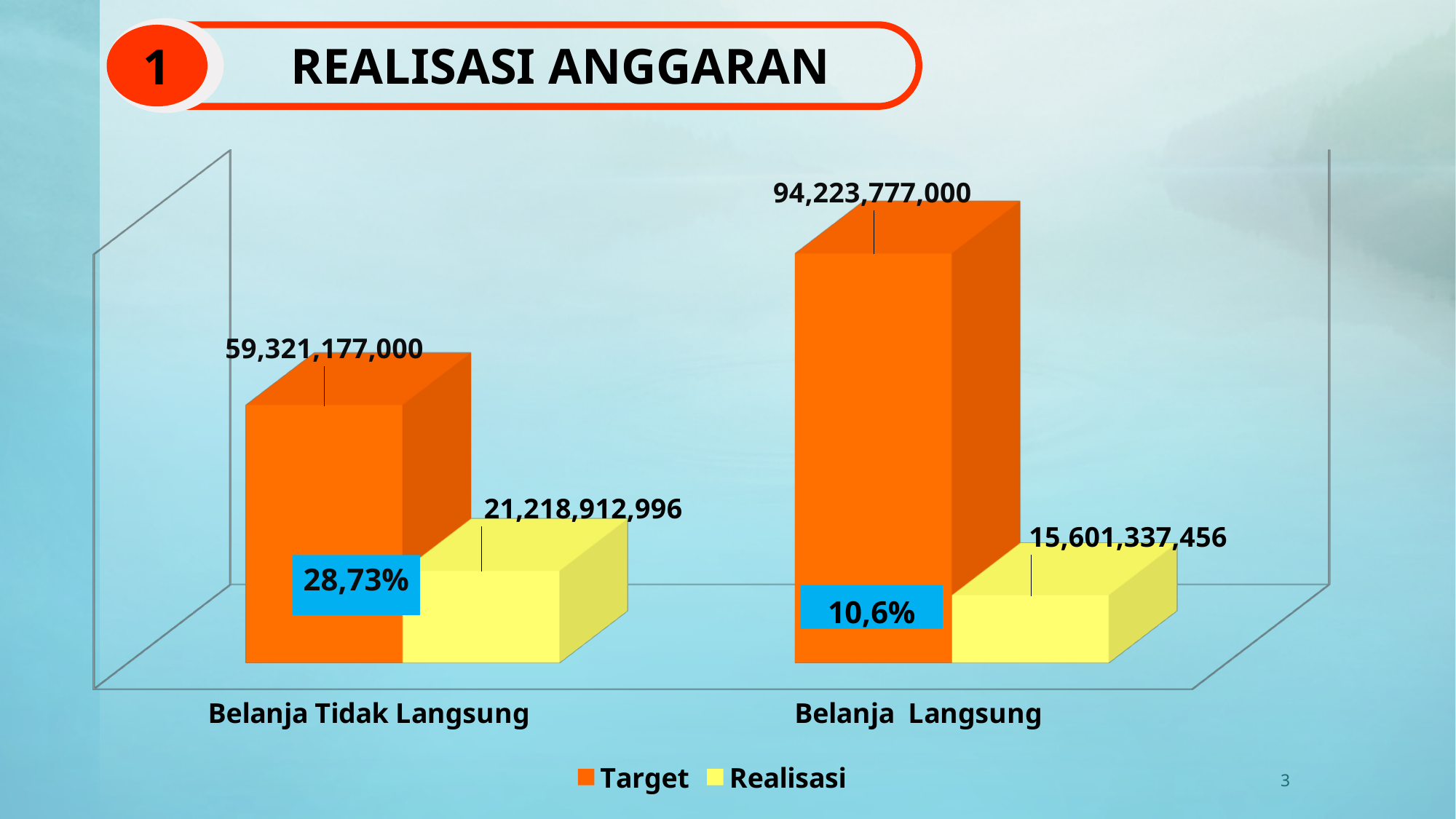
What type of chart is shown on the slide? Bar chart What percentage is shown on the Belanja Tidak Langsung bar? 28,73% What is the difference between the Realisasi values for Belanja Tidak Langsung and Belanja Langsung? 5,617,575,540 What is the Target value for Belanja Langsung? 94,223,777,000 Which category has the lower Realisasi value? Belanja Langsung What is the Realisasi value for Belanja Langsung? 15,601,337,456 What is the Target value for Belanja Tidak Langsung? 59,321,177,000 How many series does the legend list? 2 What is the Realisasi value for Belanja Tidak Langsung? 21,218,912,996 Which category has the higher Target value? Belanja Langsung What percentage is shown on the Belanja Langsung bar? 10,6% What is the difference between the Target and Realisasi values for Belanja Langsung? 78,622,439,544